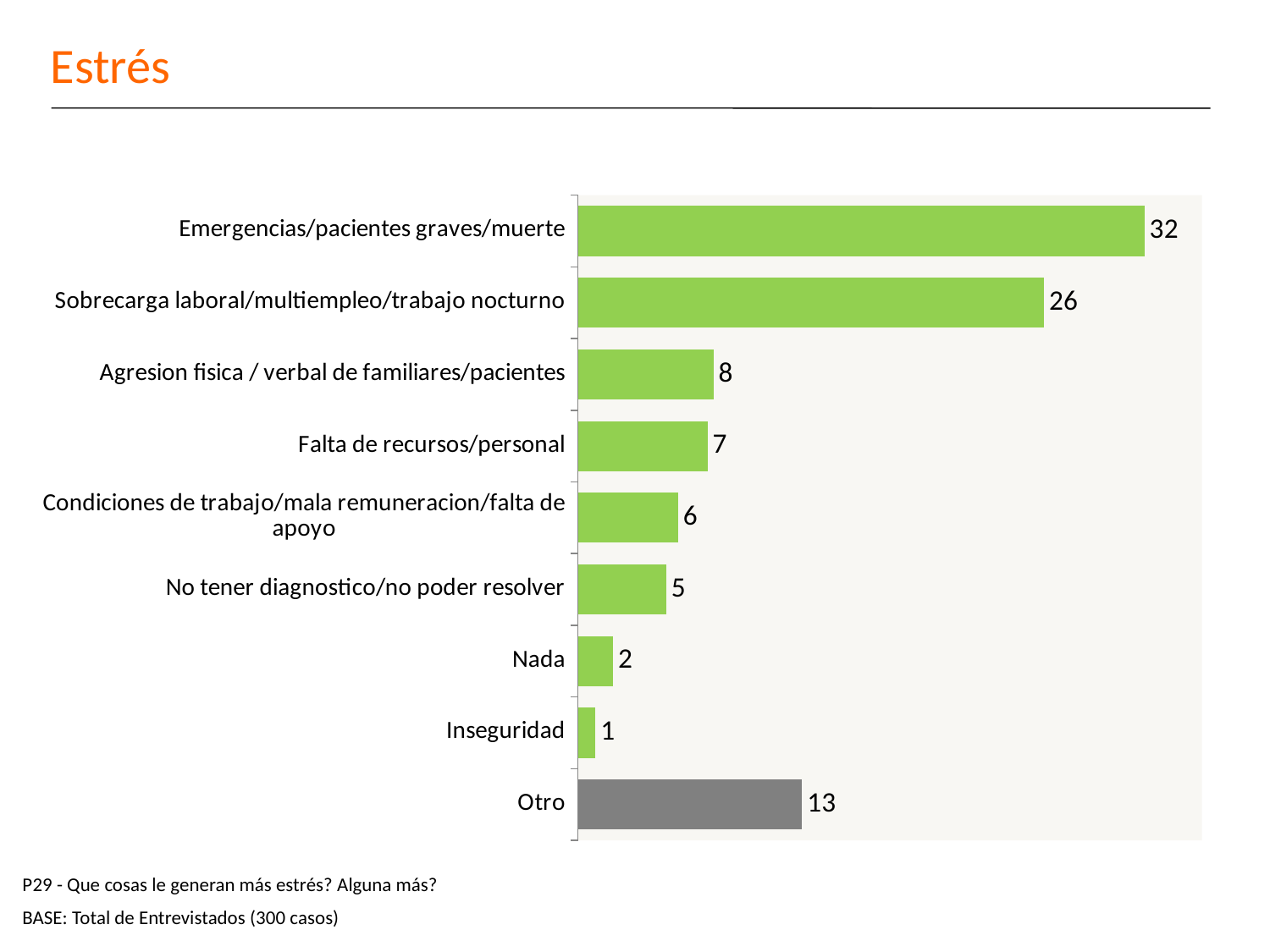
Which is larger, the value for Agresion fisica / verbal de familiares/pacientes or the value for Falta de recursos/personal? Agresion fisica / verbal de familiares/pacientes Which category has the lowest value? Inseguridad What is the value for Inseguridad? 1 What is the value for Emergencias/pacientes graves/muerte? 32 What is the value for Otro? 13 Which bar is shown in a different colour (grey) from the others? Otro What kind of chart is shown on the slide? Bar chart Which category has the highest value? Emergencias/pacientes graves/muerte What is the difference between the values for Otro and Nada? 11 What is the difference between the values for Emergencias/pacientes graves/muerte and Sobrecarga laboral/multiempleo/trabajo nocturno? 6 How many categories are shown in the chart? 9 What is the value for Sobrecarga laboral/multiempleo/trabajo nocturno? 26